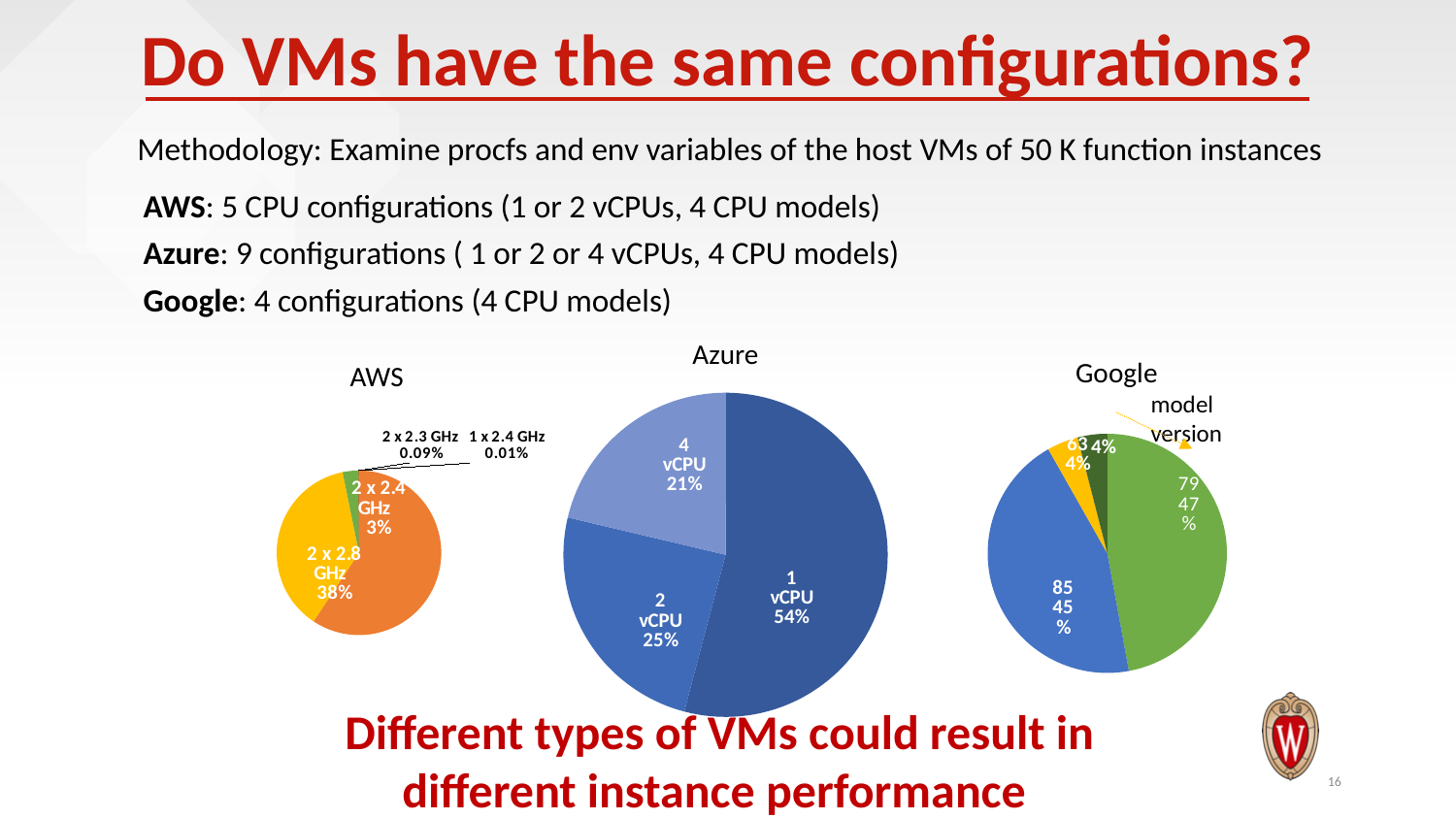
In the Azure chart, how much larger is the 1 vCPU share than the 2 vCPU share? 29% What kind of chart is the AWS chart? pie chart In the AWS chart, what share does the 1 x 2.4 GHz configuration have? 0.01% In the Azure chart, which vCPU configuration has the smallest share? 4 vCPU How many pie charts are shown on the slide? 3 In the Azure chart, what share do 4 vCPU instances have? 21% In the Azure chart, which vCPU configuration has the largest share? 1 vCPU In the Google chart, what share does CPU model version 79 have? 47% In the Azure chart, what share do 1 vCPU instances have? 54% In the AWS chart, what share does the 2 x 2.8 GHz configuration have? 38% In the Google chart, which has the larger share, model version 79 or model version 85? 79 How many slices does the Azure pie chart have? 3